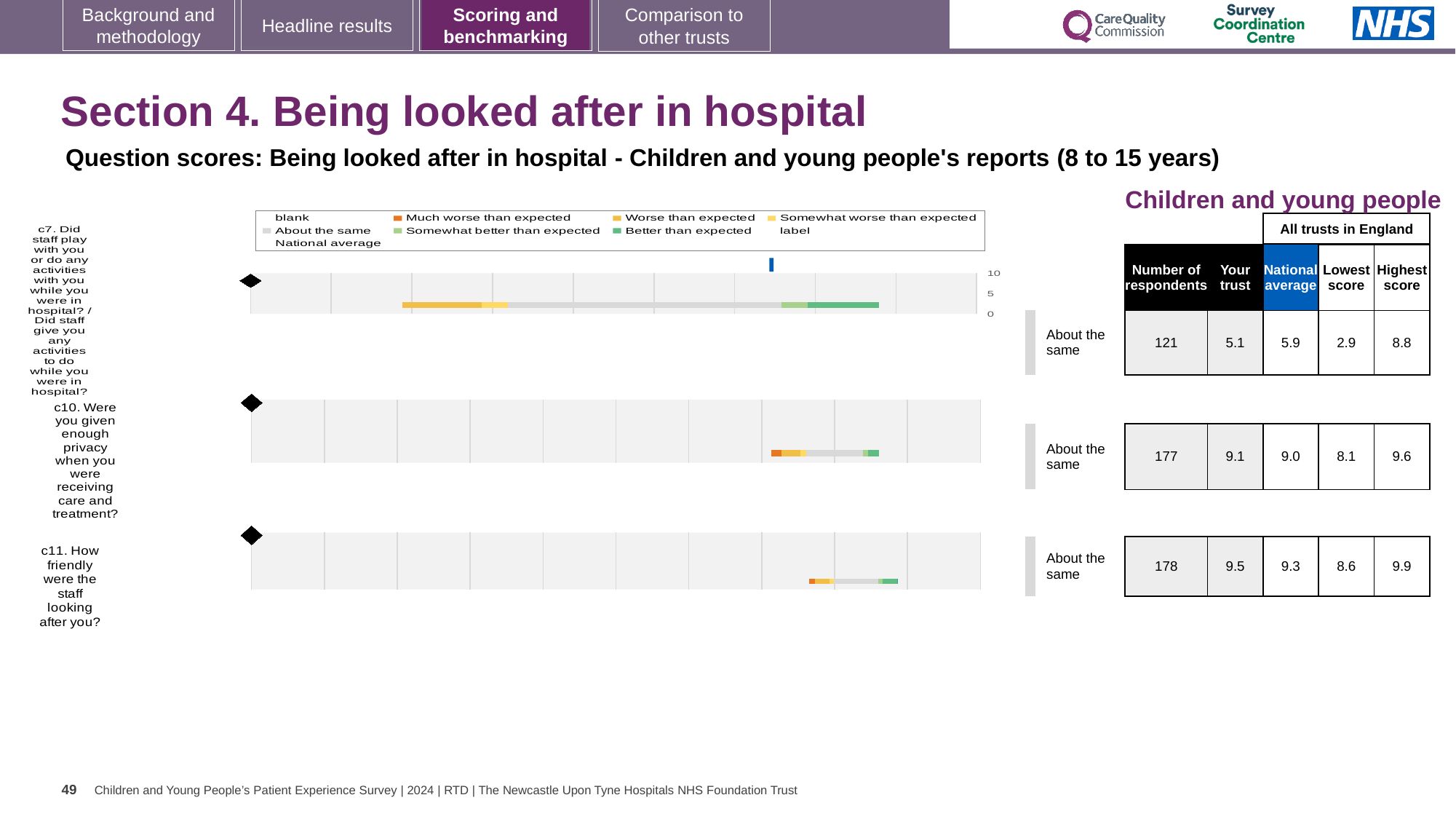
Which question has the highest 'Your trust' score? c11 What kind of chart is used to show the question scores on this slide? bar chart How many respondents answered c7 (Did staff play with you or do any activities with you while you were in hospital?)? 121 How many entries does the chart legend list? 9 How many survey questions (chart rows) are plotted on this slide? 3 What is the national average score for c10 (Were you given enough privacy when you were receiving care and treatment?)? 9.0 For c7, which is larger: the 'Your trust' score or the national average? National average What is the 'Your trust' score for c11 (How friendly were the staff looking after you?)? 9.5 Which question has the lowest 'Your trust' score? c7 For c7, what is the difference between the highest score and the lowest score across all trusts in England? 5.9 What benchmark category is shown for c10? About the same For c11, how much higher is the 'Your trust' score than the national average? 0.2